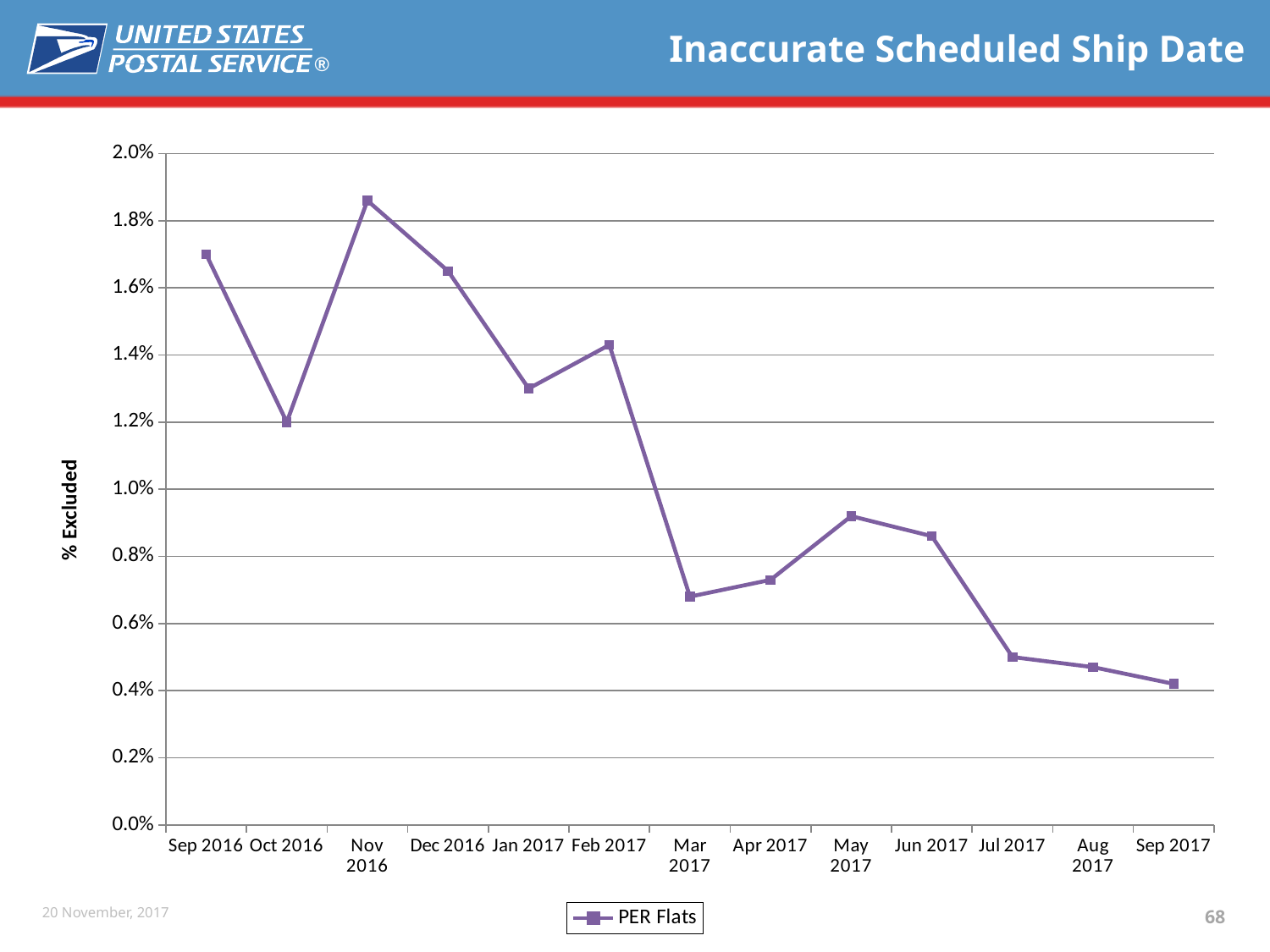
What is the label on the vertical axis? % Excluded How many months are plotted along the x axis? 13 How many series does the legend list? 1 Overall, do the values rise or fall from Sep 2016 to Sep 2017? fall Is the value for Oct 2016 greater or less than 1.4%? less Is the value for Nov 2016 greater or less than 1.8%? greater Which is larger, the value for Feb 2017 or the value for Mar 2017? Feb 2017 What is the name of the series shown in the legend? PER Flats What kind of chart is shown on the slide? line chart Which month has the lowest value for PER Flats? Sep 2017 Is the value for Mar 2017 greater or less than 0.8%? less Which month has the highest value for PER Flats? Nov 2016